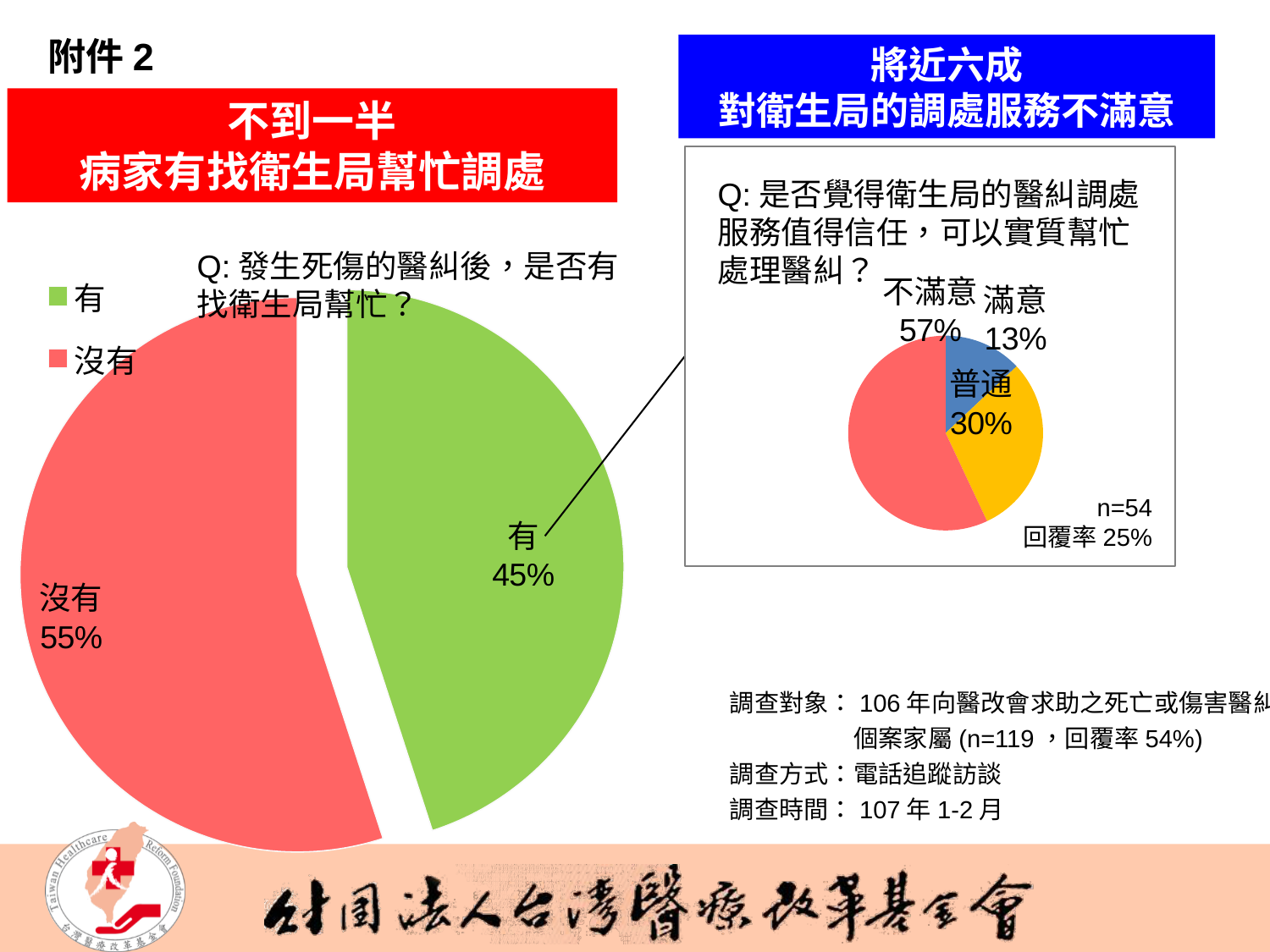
In the small pie chart on the right, what percentage of respondents answered 滿意 (satisfied)? 13% In the small pie chart on the right, what percentage of respondents answered 普通 (neutral)? 30% How many slices does the small pie chart on the right have? 3 In the small pie chart on the right, which category has the smallest share? 滿意 In the large pie chart on the left, what is the difference in percentage points between 沒有 and 有? 10 In the small pie chart on the right, what percentage of respondents answered 不滿意 (dissatisfied)? 57% What type of chart is the large chart on the left? Pie chart In the large pie chart on the left, what percentage of respondents answered 有 (yes)? 45% How many entries does the legend of the large pie chart on the left list? 2 In the large pie chart on the left, what percentage of respondents answered 沒有 (no)? 55% In the small pie chart on the right, which category has the largest share? 不滿意 In the large pie chart on the left, which slice is larger, 有 or 沒有? 沒有